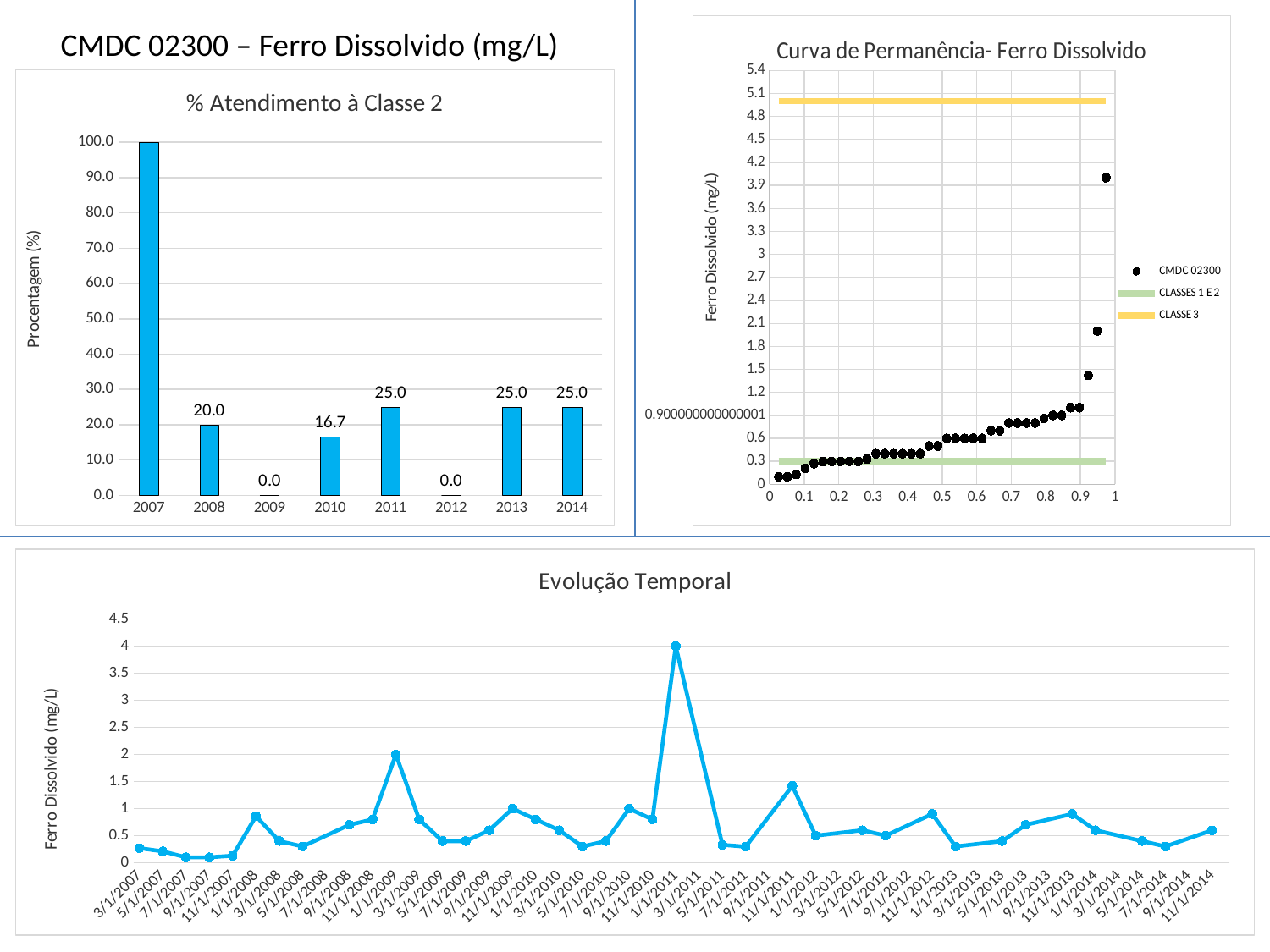
In the 'Curva de Permanência- Ferro Dissolvido' chart, what is the label of the y axis? Ferro Dissolvido (mg/L) In the '% Atendimento à Classe 2' chart, what is the value for 2010? 16.7 In the '% Atendimento à Classe 2' chart, what is the value for 2008? 20.0 In the '% Atendimento à Classe 2' chart, which year has the highest value? 2007 In the '% Atendimento à Classe 2' chart, how many years have a value of 0.0? 2 In the '% Atendimento à Classe 2' chart, how many years are shown on the x axis? 8 What kind of chart is '% Atendimento à Classe 2'? bar chart What kind of chart is 'Evolução Temporal'? line chart In the 'Evolução Temporal' chart, is the value for 1/1/2011 greater or less than 3.5? greater In the '% Atendimento à Classe 2' chart, which year has the larger value, 2008 or 2010? 2008 In the 'Curva de Permanência- Ferro Dissolvido' chart, how many entries does the legend list? 3 In the '% Atendimento à Classe 2' chart, what is the difference between the values for 2011 and 2010? 8.3